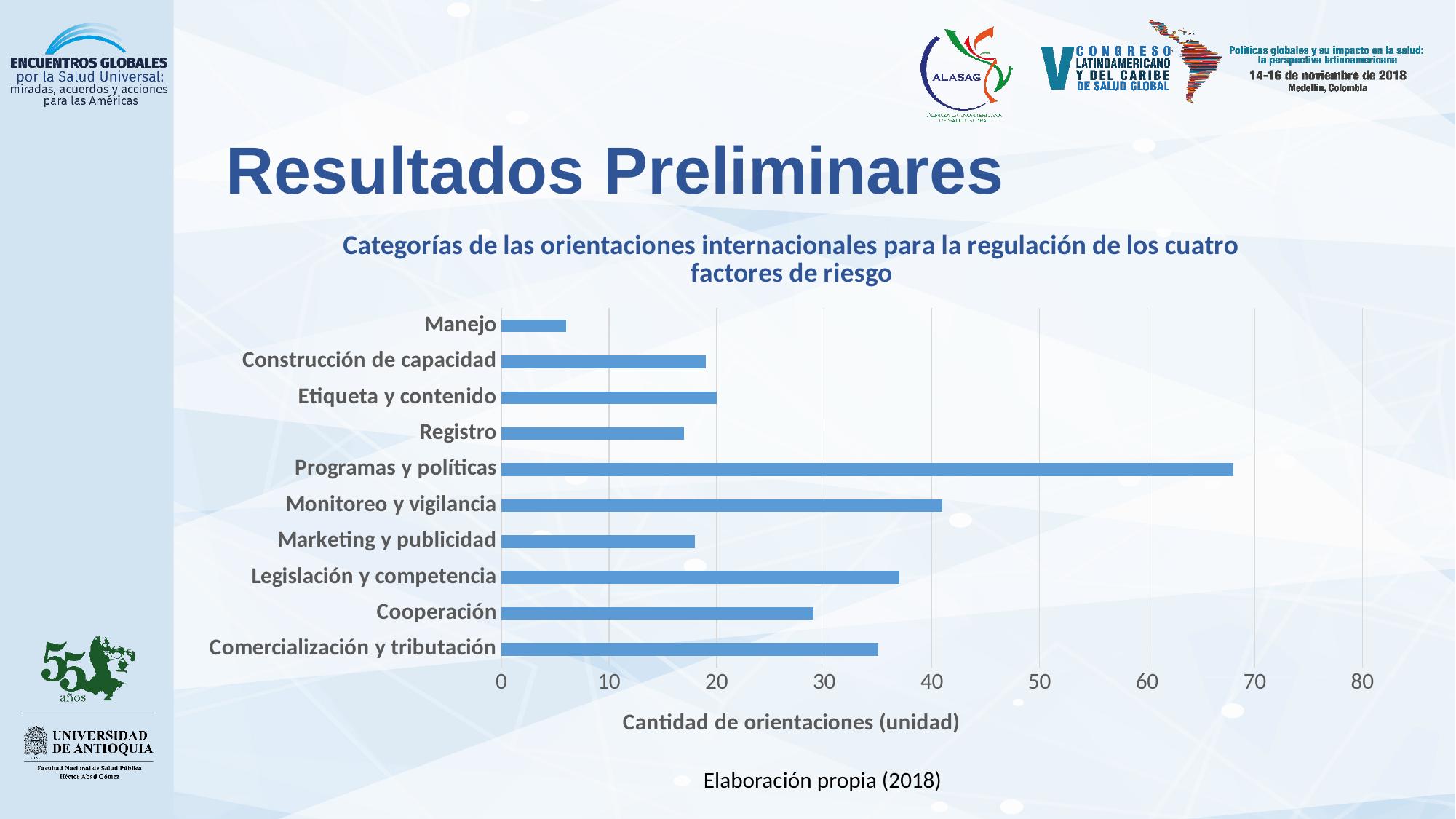
How many categories are shown in the chart? 10 What is the title of the chart? Categorías de las orientaciones internacionales para la regulación de los cuatro factores de riesgo Is the value for Manejo greater or less than 10? less Which category has the lowest number of orientaciones? Manejo Is the value for Programas y políticas greater or less than 60? greater Which category has the highest number of orientaciones? Programas y políticas Which is larger, the value for Legislación y competencia or the value for Cooperación? Legislación y competencia Which is larger, the value for Monitoreo y vigilancia or the value for Comercialización y tributación? Monitoreo y vigilancia What kind of chart is shown on the slide? bar chart What is the label of the horizontal axis of the chart? Cantidad de orientaciones (unidad)